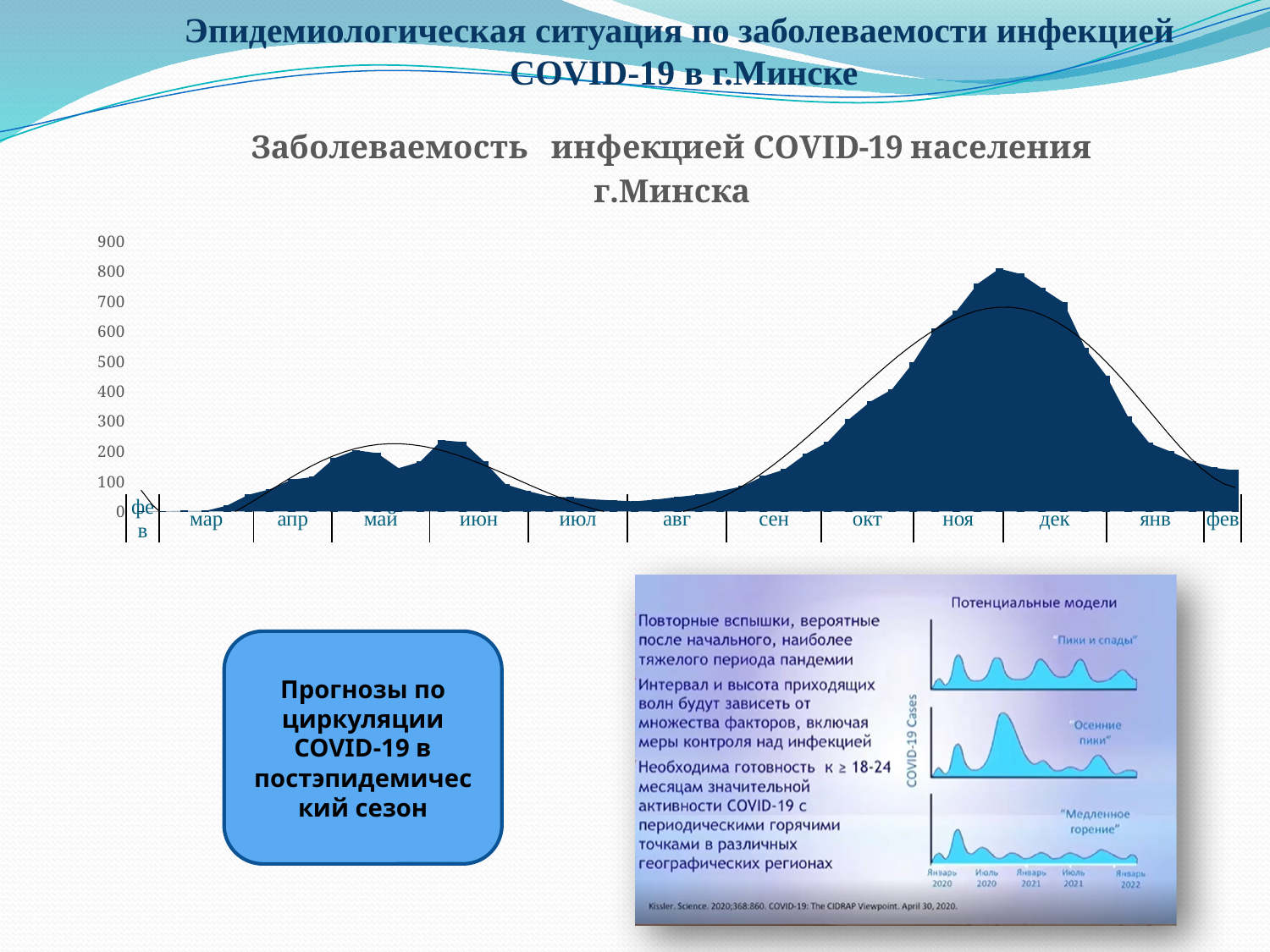
What is the highest value shown on the vertical axis of the chart? 900 What is the title of the chart? Заболеваемость инфекцией COVID-19 населения г.Минска What kind of chart is used to show COVID-19 incidence in Minsk? area chart Which is higher on the chart, the peak in ноя or the peak in май? ноя How many month labels are shown along the x axis of the chart? 13 Do the values rise or fall from дек to фев at the right end of the chart? fall Which is higher on the chart, the value in май or the value in июл? май Do the values rise or fall from сен to ноя? rise Is the value in июл greater or less than 100? less Is the peak value in май greater or less than 300? less